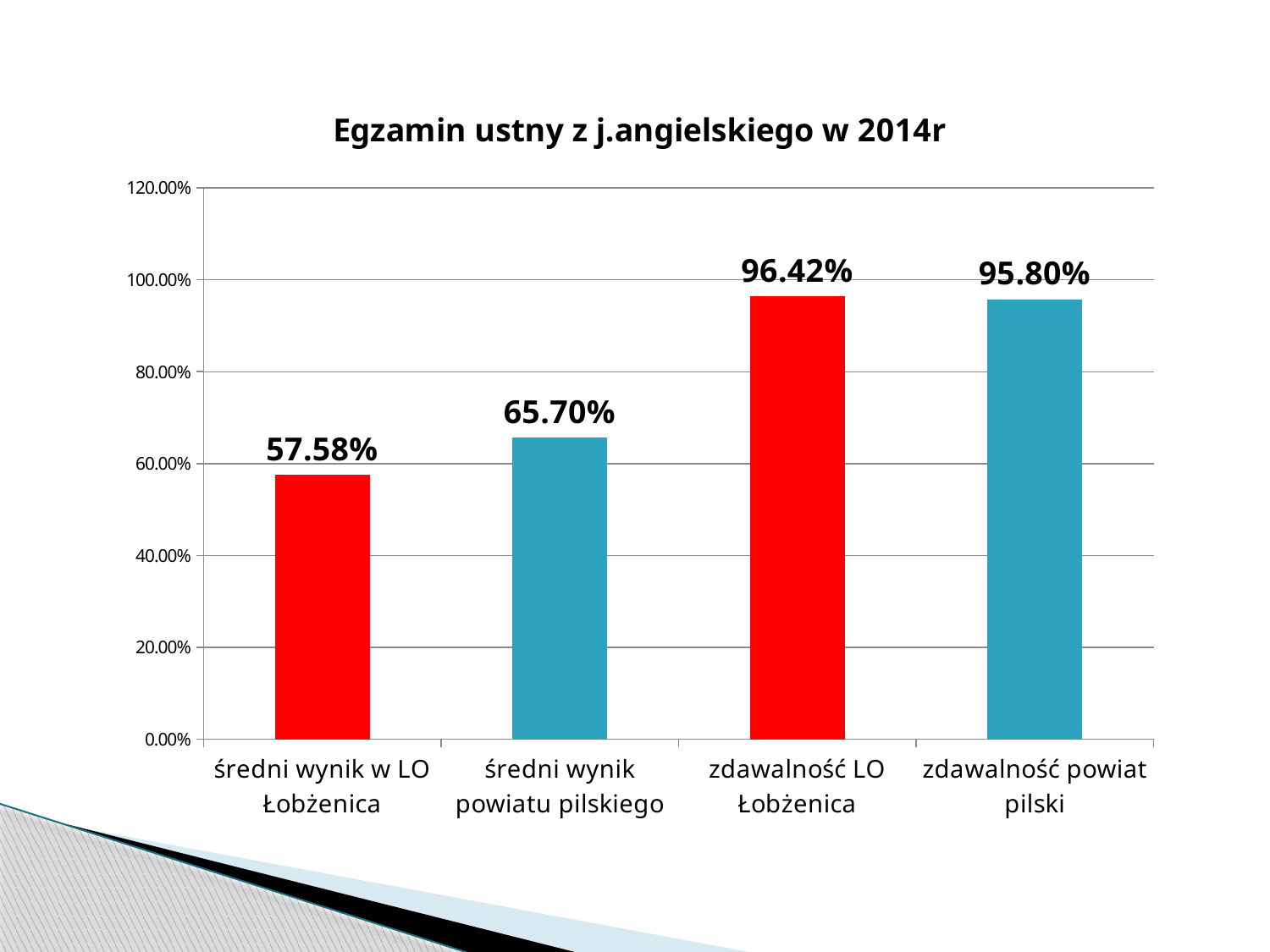
Which category has the highest value? zdawalność LO Łobżenica What is the title of the chart? Egzamin ustny z j.angielskiego w 2014r What is the difference between średni wynik powiatu pilskiego and średni wynik w LO Łobżenica? 8.12% How many categories are shown in the chart? 4 Is the value for zdawalność powiat pilski greater or less than 80.00%? greater What is the difference between zdawalność LO Łobżenica and zdawalność powiat pilski? 0.62% What is the value for zdawalność LO Łobżenica? 96.42% What is the value for zdawalność powiat pilski? 95.80% What is the value for średni wynik powiatu pilskiego? 65.70% Which is larger, średni wynik w LO Łobżenica or średni wynik powiatu pilskiego? średni wynik powiatu pilskiego What is the value for średni wynik w LO Łobżenica? 57.58% Which category has the lowest value? średni wynik w LO Łobżenica